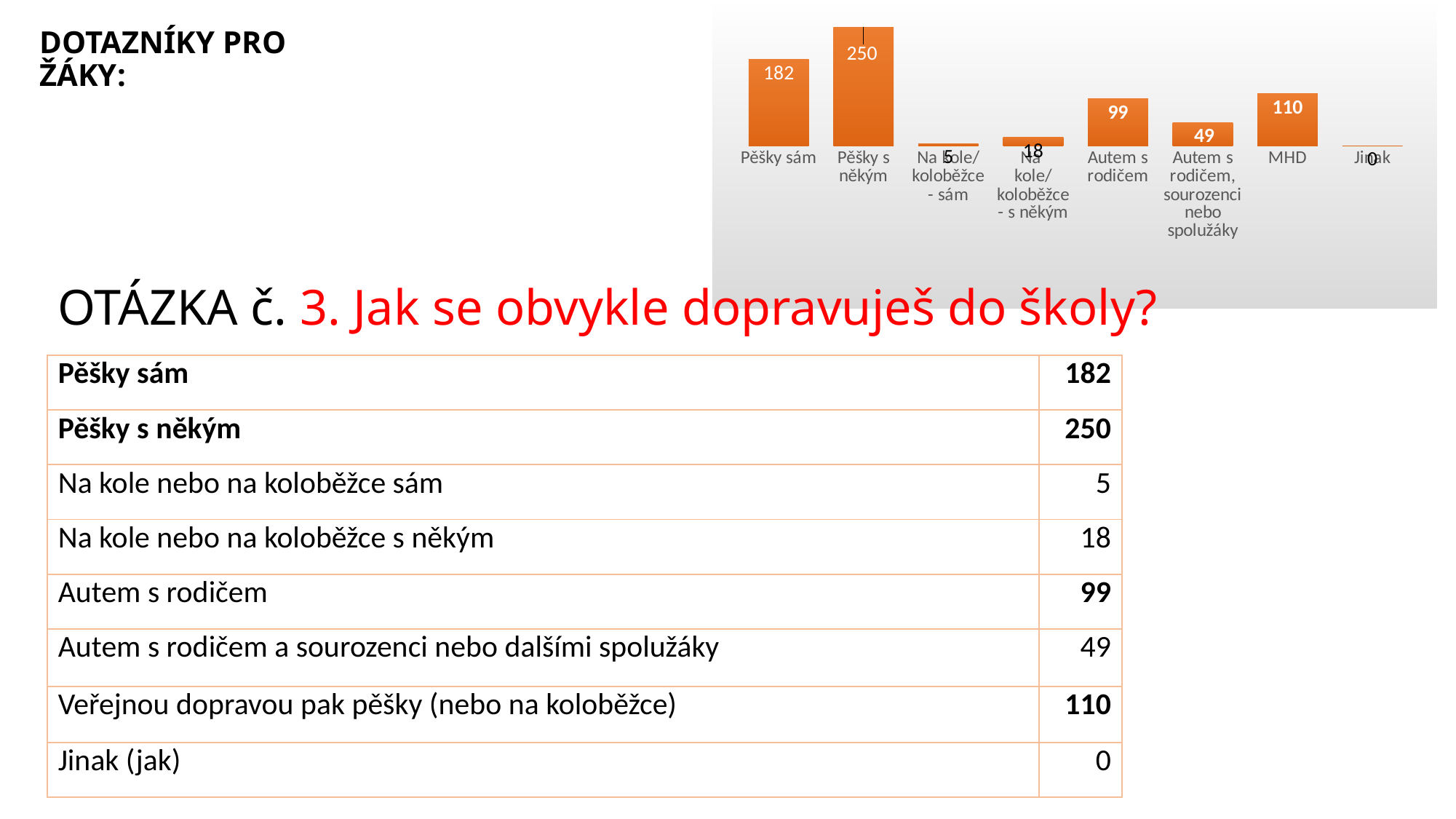
What kind of chart is shown? bar chart Which is larger, Autem s rodičem or Autem s rodičem, sourozenci nebo spolužáky? Autem s rodičem Which category has the highest value? Pěšky s někým How many categories are shown in the chart? 8 What is the difference between Pěšky s někým and Pěšky sám? 68 What is the value for Autem s rodičem? 99 What is the value for Pěšky sám? 182 What is the value for MHD? 110 What colour are the bars in the chart? orange Which category has the lowest value? Jinak What is the difference between MHD and Autem s rodičem? 11 What is the value for Jinak? 0